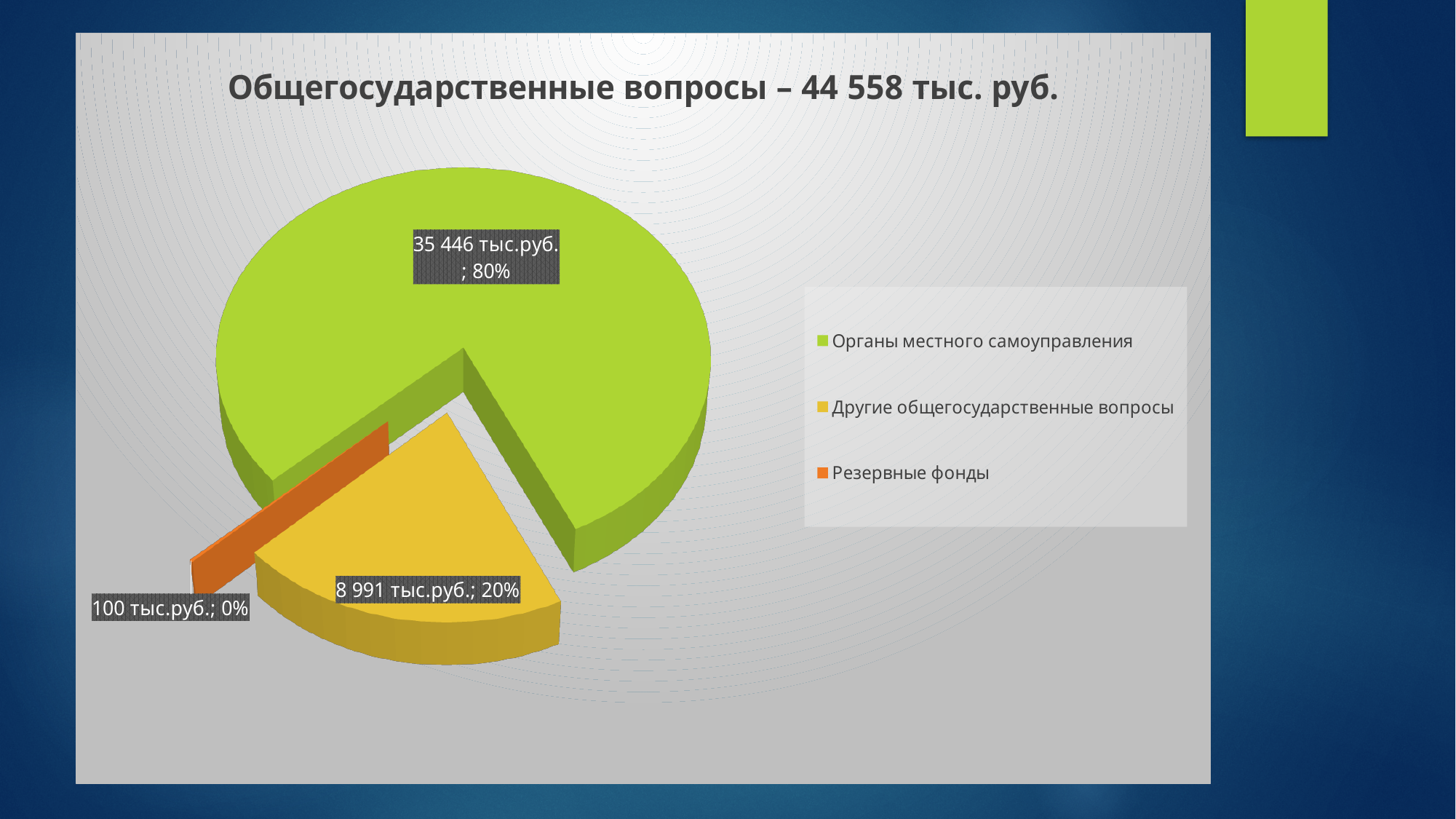
What is the difference between the values for Органы местного самоуправления and Другие общегосударственные вопросы? 26 455 тыс.руб. What share of the pie does Органы местного самоуправления take? 80% Which category has the largest slice? Органы местного самоуправления What share of the pie does Другие общегосударственные вопросы take? 20% What kind of chart is shown on the slide? Pie chart Which is larger, Другие общегосударственные вопросы or Резервные фонды? Другие общегосударственные вопросы Which category has the smallest slice? Резервные фонды What is the value for Другие общегосударственные вопросы? 8 991 тыс.руб. What is the value for Органы местного самоуправления? 35 446 тыс.руб. How many slices does the pie chart have? 3 What is the value for Резервные фонды? 100 тыс.руб. What is the title of the chart? Общегосударственные вопросы – 44 558 тыс. руб.